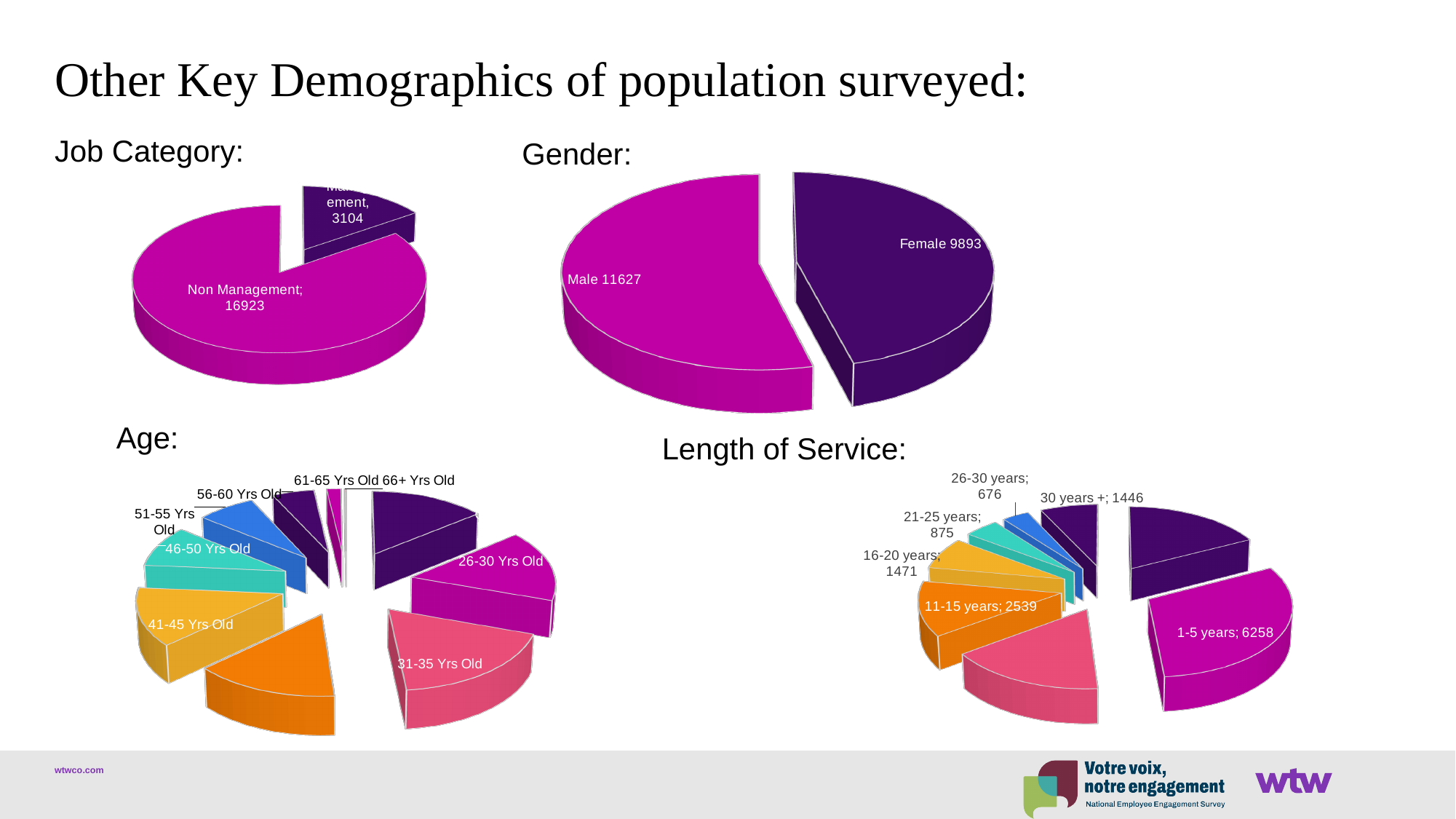
In the Gender chart, what is the value for Female? 9893 In the Length of Service chart, which labeled category has the lowest value? 26-30 years In the Gender chart, which category is larger, Male or Female? Male In the Job Category chart, what is the total of the two slices? 20027 In the Length of Service chart, what is the value for 1-5 years? 6258 In the Job Category chart, what is the value for Management? 3104 In the Gender chart, what is the value for Male? 11627 In the Gender chart, what is the difference between the Male and Female values? 1734 What kind of chart is the Gender chart? Pie chart In the Job Category chart, what is the value for Non Management? 16923 In the Length of Service chart, what is the value for 11-15 years? 2539 In the Length of Service chart, what is the difference between the 16-20 years and 30 years + values? 25